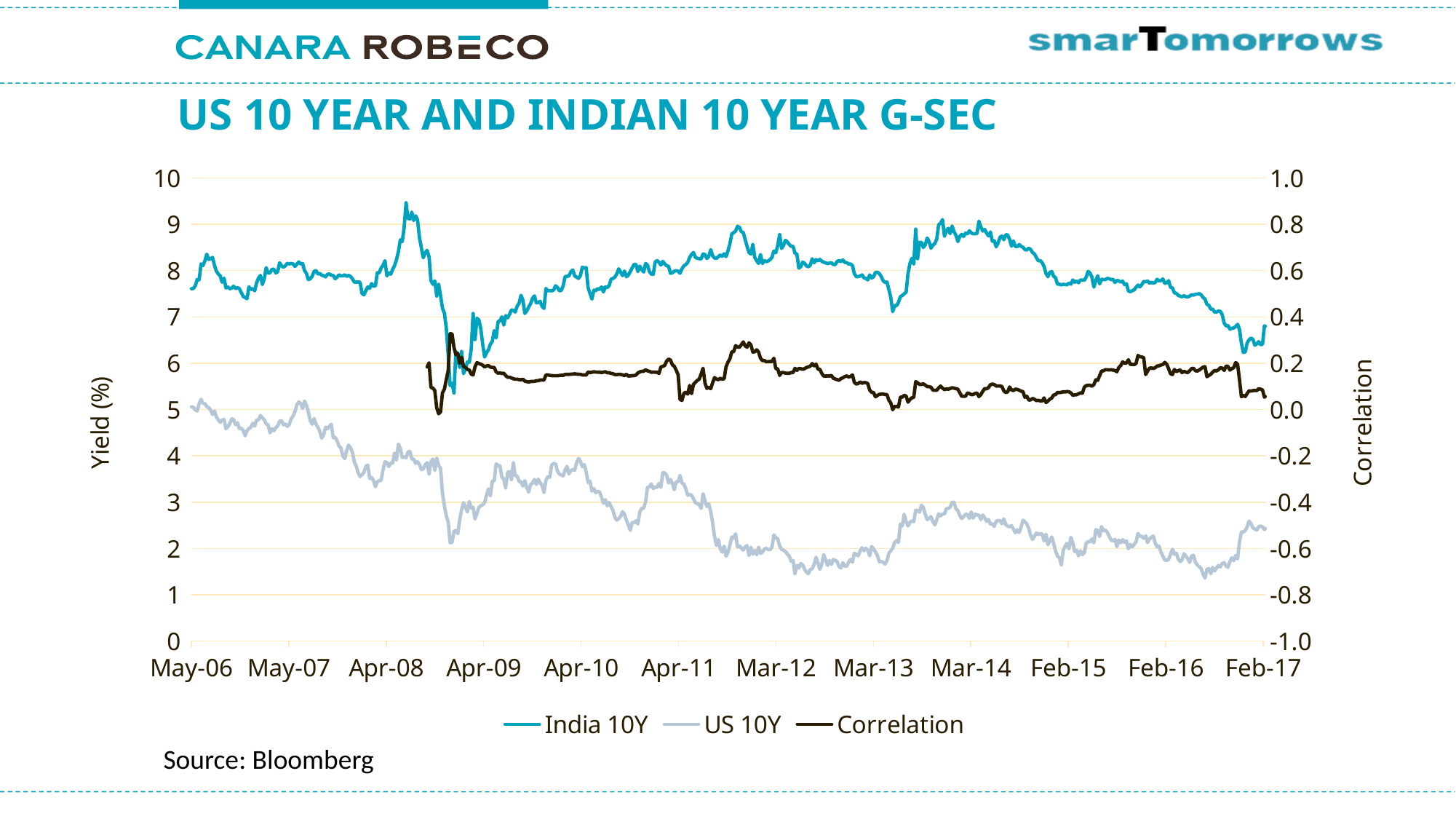
Is the peak value of the India 10Y series greater or less than 9? greater Is the lowest value of the US 10Y series greater or less than 2? less What kind of chart is shown on the slide? line chart Is the value of the India 10Y series at Feb-17 greater or less than 6? greater Which series has higher yield values throughout the period, India 10Y or US 10Y? India 10Y What is the title of the chart? US 10 YEAR AND INDIAN 10 YEAR G-SEC Does the US 10Y series rise or fall overall from May-06 to Feb-17? fall What are the three series named in the legend? India 10Y, US 10Y, Correlation How many series does the legend list? 3